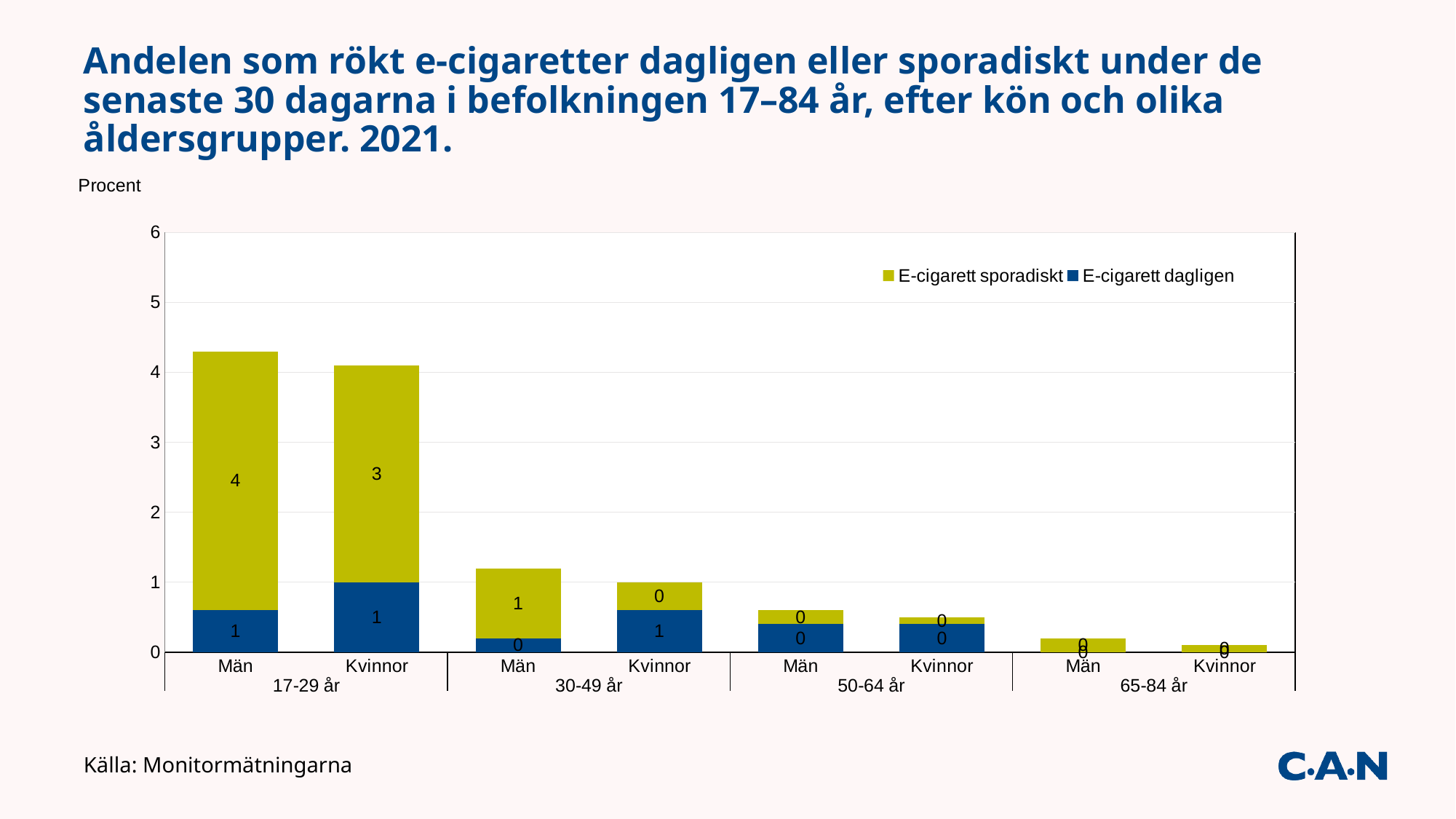
Is the total value for Män in the 17-29 år group greater or less than 4? greater How many bars are plotted in the chart? 8 What is the data label for E-cigarett dagligen for Kvinnor in the 30-49 år group? 1 Do the total bar values rise or fall as the age groups get older along the x axis? Fall What is the data label for E-cigarett sporadiskt for Kvinnor in the 17-29 år group? 3 Is the total value for Män in the 50-64 år group greater or less than 1? less What are the two series named in the legend? E-cigarett sporadiskt and E-cigarett dagligen How many series does the legend list? 2 What is the data label for E-cigarett sporadiskt for Män in the 17-29 år group? 4 What kind of chart is shown on the slide? Stacked bar chart What is the data label for E-cigarett sporadiskt for Män in the 30-49 år group? 1 Which bar has the highest total value? Män, 17-29 år